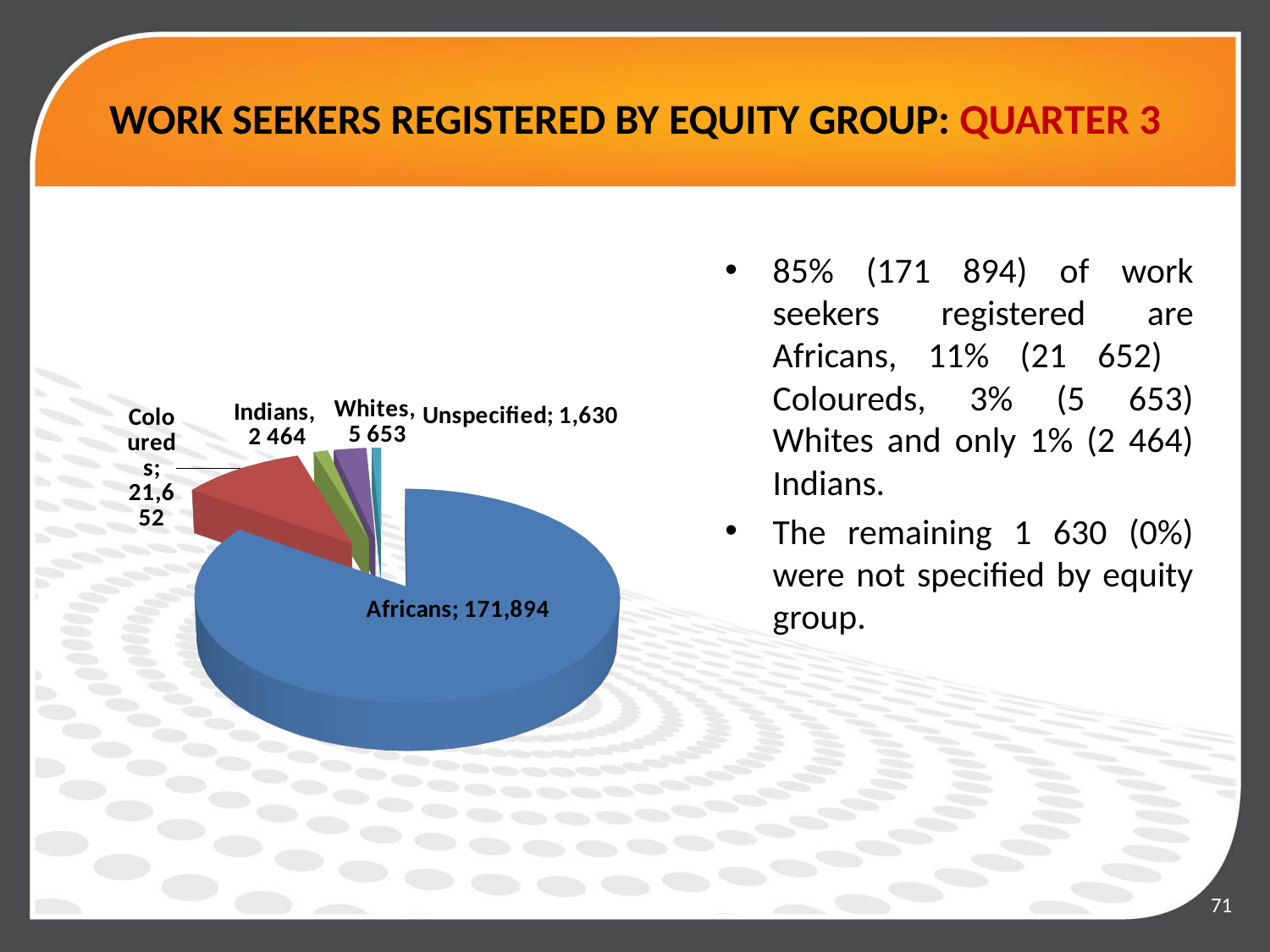
What is the number of work seekers registered for Africans? 171,894 What is the number of work seekers registered for Coloureds? 21,652 What share of registered work seekers are Africans? 85% What is the number of work seekers whose equity group is Unspecified? 1,630 What is the number of work seekers registered for Whites? 5 653 How many equity groups (slices) are shown in the pie chart? 5 Which equity group has the largest number of registered work seekers? Africans What is the number of work seekers registered for Indians? 2 464 What type of chart is shown on the slide? pie chart What is the difference between the number of Whites and the number of Indians registered? 3,189 Which group has more registered work seekers, Whites or Indians? Whites Which equity group has the smallest number of registered work seekers? Unspecified